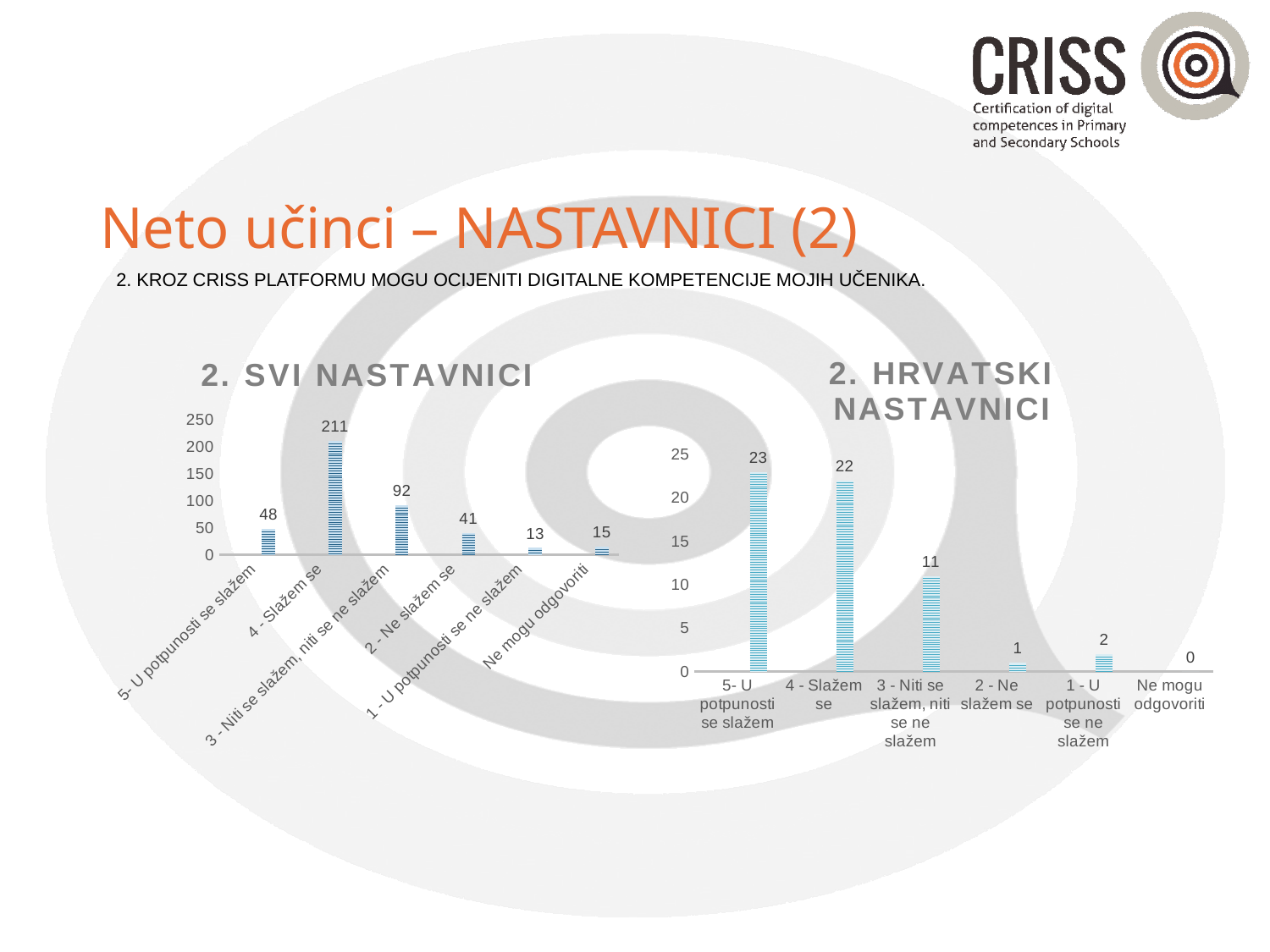
In the chart titled "2. HRVATSKI NASTAVNICI", which category has the highest value? 5- U potpunosti se slažem In the chart titled "2. SVI NASTAVNICI", which category has the lowest value? 1 - U potpunosti se ne slažem In the chart titled "2. HRVATSKI NASTAVNICI", what is the value for "3 - Niti se slažem, niti se ne slažem"? 11 In the chart titled "2. SVI NASTAVNICI", how many categories are shown on the x axis? 6 In the chart titled "2. HRVATSKI NASTAVNICI", what is the difference between the values for "5- U potpunosti se slažem" and "4 - Slažem se"? 1 In the chart titled "2. HRVATSKI NASTAVNICI", which is larger: the value for "2 - Ne slažem se" or the value for "1 - U potpunosti se ne slažem"? 1 - U potpunosti se ne slažem In the chart titled "2. SVI NASTAVNICI", what is the difference between the values for "4 - Slažem se" and "3 - Niti se slažem, niti se ne slažem"? 119 What kind of chart is the chart titled "2. SVI NASTAVNICI"? Bar chart In the chart titled "2. HRVATSKI NASTAVNICI", what is the value for "Ne mogu odgovoriti"? 0 In the chart titled "2. SVI NASTAVNICI", which category has the highest value? 4 - Slažem se In the chart titled "2. SVI NASTAVNICI", what is the value for "4 - Slažem se"? 211